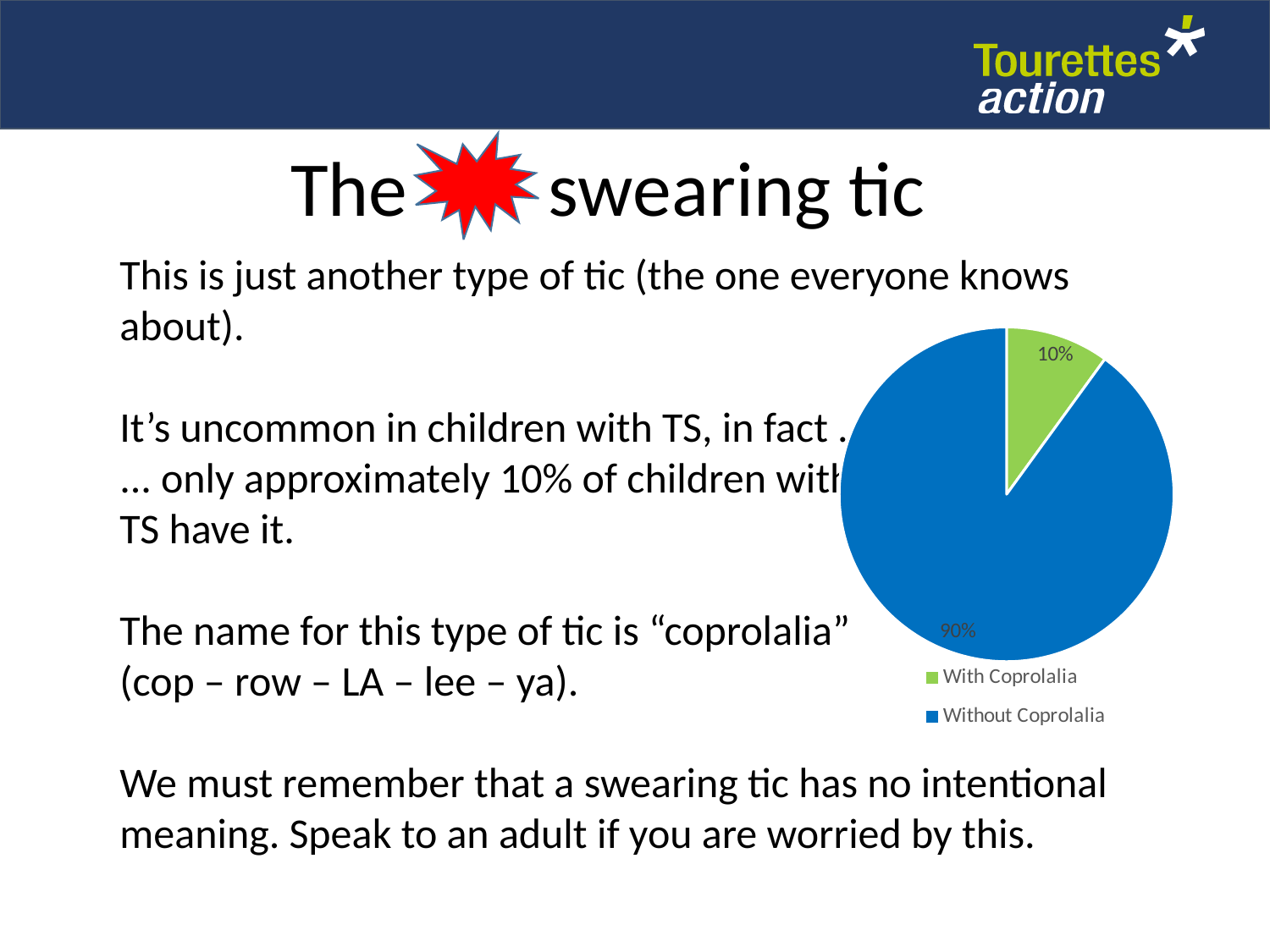
Which is larger, the "With Coprolalia" slice or the "Without Coprolalia" slice? Without Coprolalia How many slices does the pie chart have? 2 What colour is the "With Coprolalia" slice? green What colour is the "Without Coprolalia" slice? blue Which slice of the pie is the smallest? With Coprolalia What is the difference in percentage points between the "Without Coprolalia" and "With Coprolalia" slices? 80 Which slice of the pie is the largest? Without Coprolalia What share of the pie is labelled "Without Coprolalia"? 90% What kind of chart is shown on the slide? pie chart How many entries does the legend list? 2 What share of the pie is labelled "With Coprolalia"? 10%